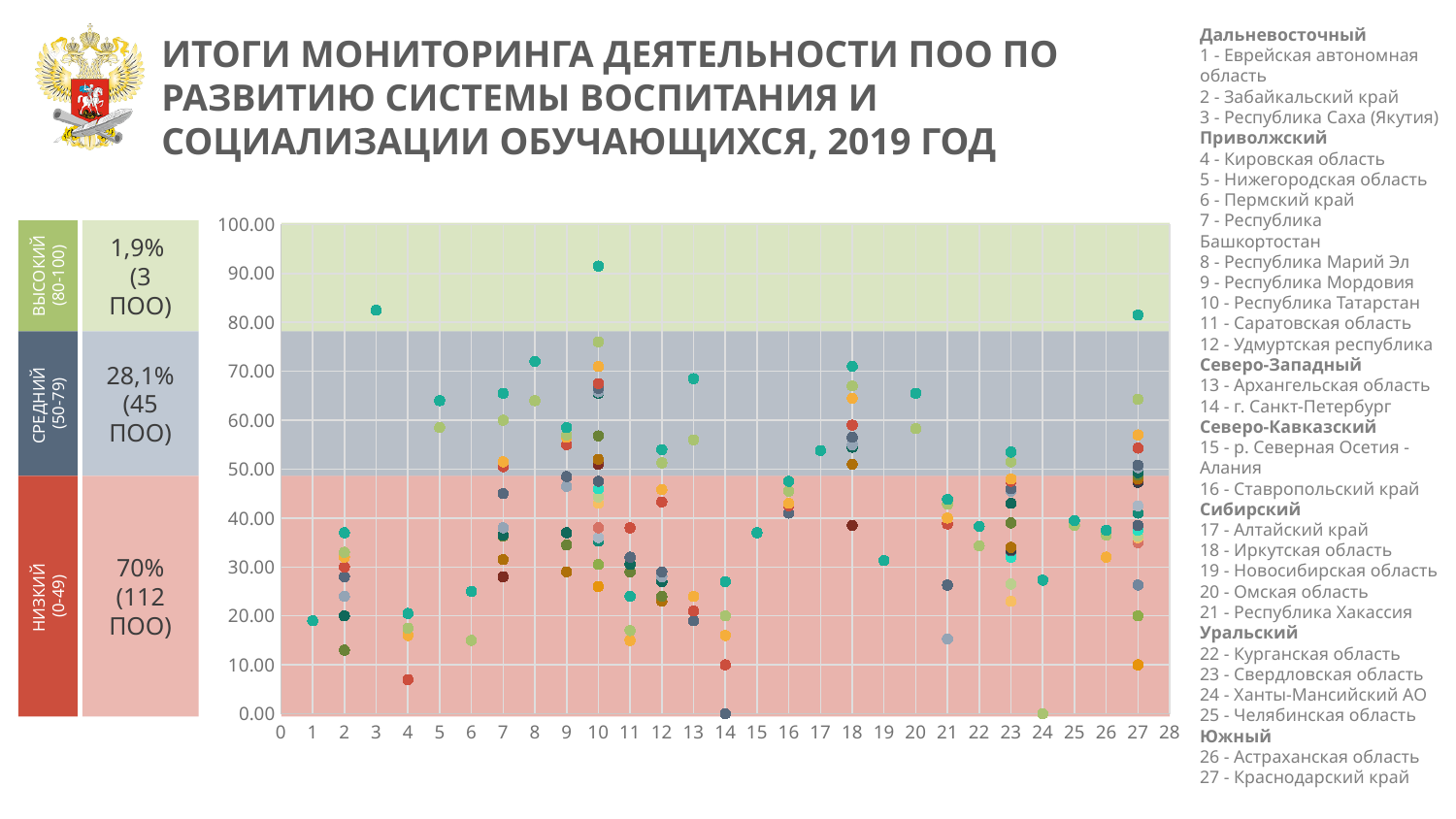
How many regions are numbered in the list to the right of the chart? 27 Is the lowest point at x-axis position 4 greater or less than 10? less Is the point at x-axis position 1 greater or less than 30? less Is the highest point at x-axis position 10 greater or less than 80? greater What is the highest number shown on the x axis of the chart? 28 According to the panel to the left of the chart, what percentage of ПОО fall in the low (НИЗКИЙ, 0-49) band? 70% What is the highest value shown on the y axis of the chart? 100.00 According to the panel to the left of the chart, how many ПОО fall in the high (ВЫСОКИЙ, 80-100) band? 3 What kind of chart is shown on the slide? scatter chart Which x-axis position has the highest plotted point on the chart? 10